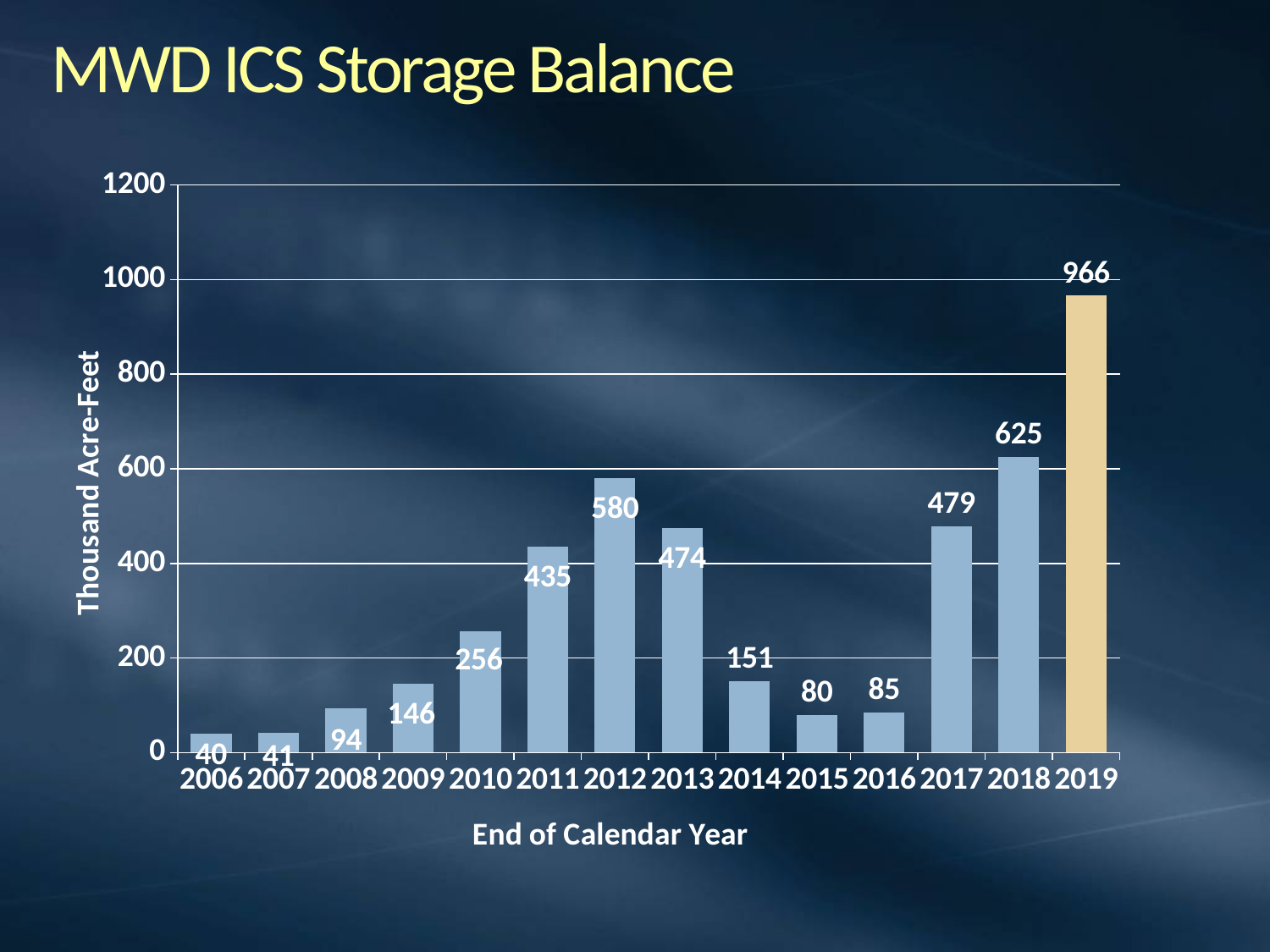
Which year has the lowest storage balance? 2006 Is the value for 2018 greater or less than 600? greater What is the MWD ICS storage balance at the end of 2012? 580 What is the difference between the 2012 and 2013 values? 106 What is the difference between the 2019 and 2018 values? 341 What is the label of the y axis? Thousand Acre-Feet Which year has a larger value, 2011 or 2017? 2017 What is the value shown for 2019? 966 How many years are shown on the x axis? 14 Which year has the highest storage balance? 2019 What kind of chart is shown on the slide? Bar chart What is the storage balance for 2015? 80